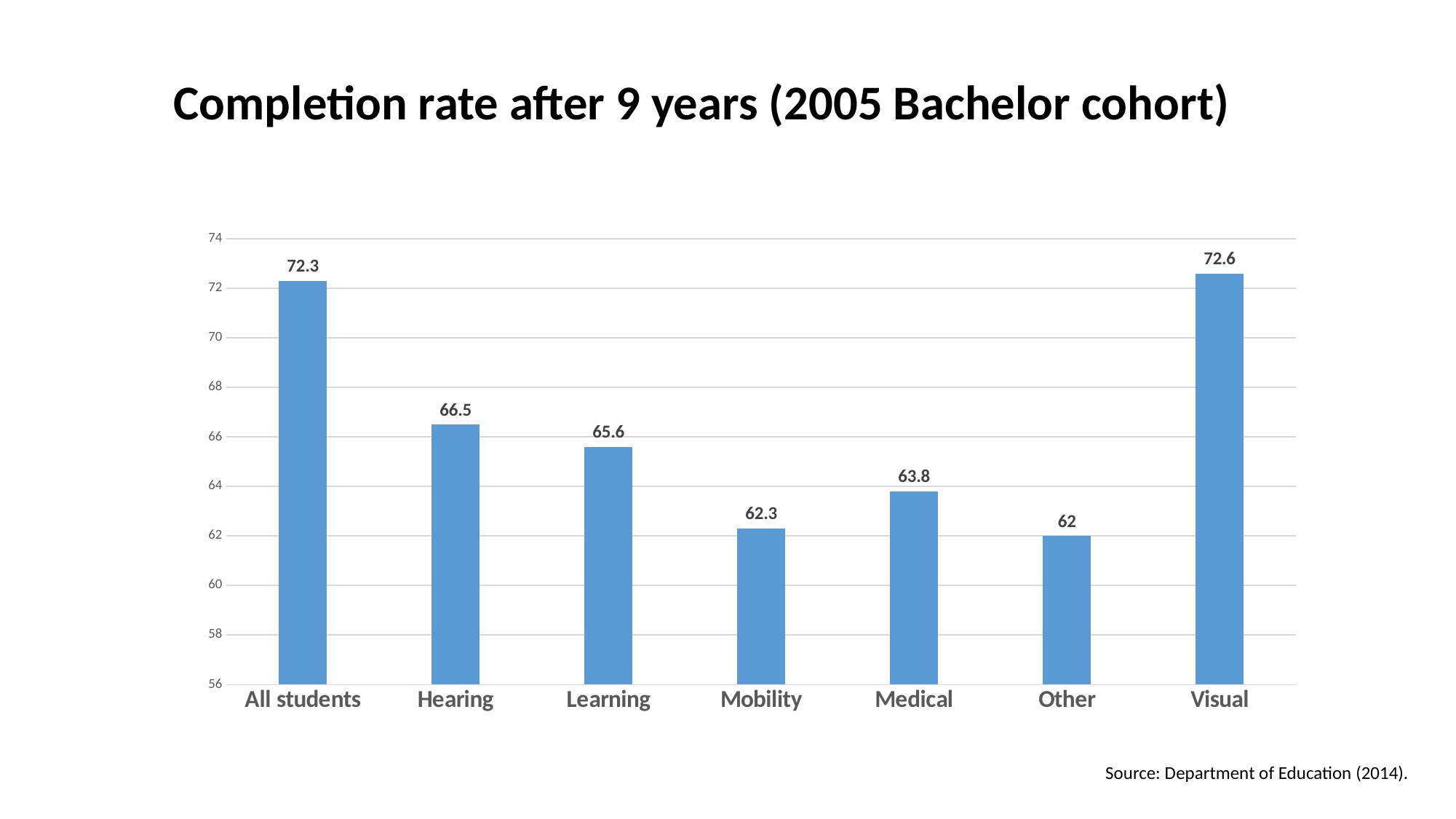
How many categories are shown on the x axis? 7 What is the completion rate for Hearing? 66.5 What is the completion rate for Mobility? 62.3 What is the completion rate for Other? 62 Which category has the lowest completion rate? Other Is the value for Learning greater or less than 64? greater What is the difference between the completion rates for Hearing and Learning? 0.9 Which has a higher completion rate, Medical or Mobility? Medical What kind of chart is shown on the slide? Bar chart What is the difference between the completion rates for All students and Medical? 8.5 What is the title of the chart? Completion rate after 9 years (2005 Bachelor cohort) What is the completion rate for Visual? 72.6